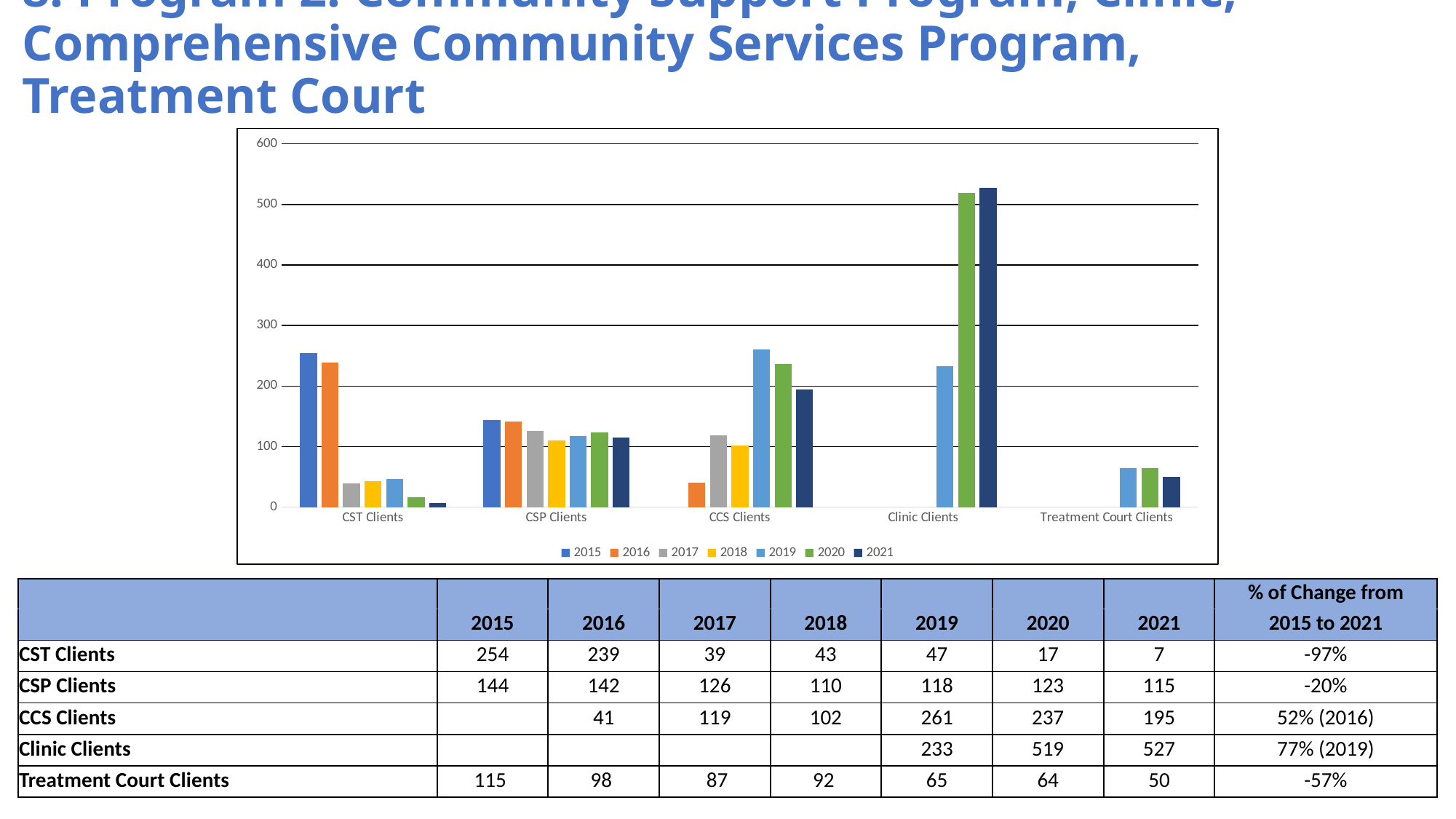
Is the 2020 bar for Clinic Clients greater or less than 500? greater How many client categories are shown along the x axis of the chart? 5 Which client category has the tallest bar in the chart? Clinic Clients Which is larger in 2019: CCS Clients or CSP Clients? CCS Clients How many series does the chart's legend list? 7 What colour represents the 2016 series in the chart's legend? orange Do the CST Clients values rise or fall from 2015 to 2021? fall According to the table, how many CST Clients were there in 2015? 254 Is the 2021 bar for CST Clients greater or less than 100? less Using the table values, what is the difference between Clinic Clients in 2021 and in 2019? 294 What kind of chart is shown on the slide? bar chart What is the % of change from 2015 to 2021 shown for CSP Clients? -20%